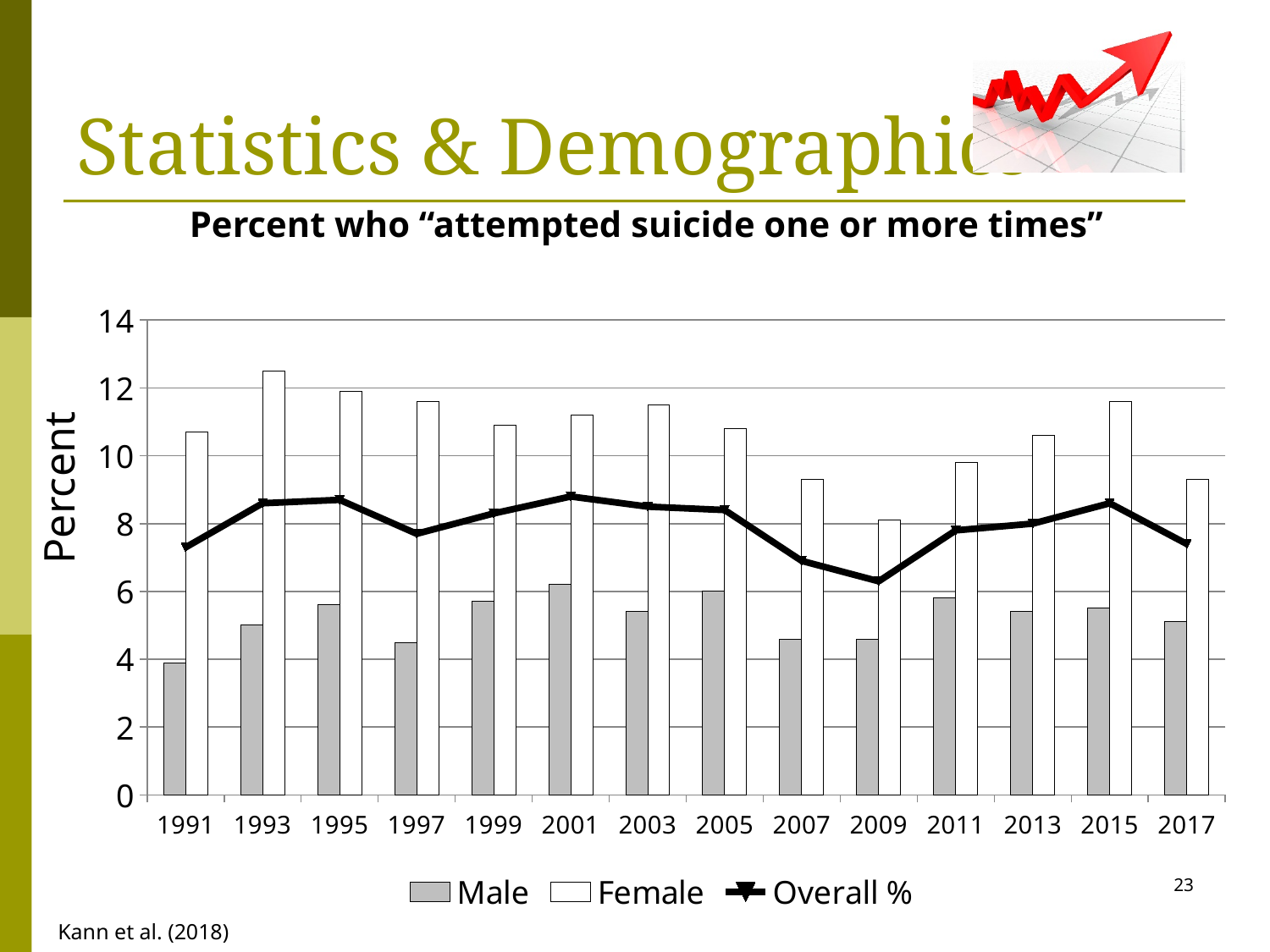
How many series does the legend list? 3 What is the label on the y axis? Percent In which year is the Male value lowest? 1991 In which year is the Overall % value lowest? 2009 Is the Female value for 1993 greater or less than 12? greater How many years are shown on the x axis? 14 In which year is the Female value highest? 1993 In which year is the Female value lowest? 2009 Which is larger in 2005, the Male value or the Female value? Female What kind of chart is shown on the slide? A bar chart with a line series Is the Overall % value for 2009 greater or less than 8? less